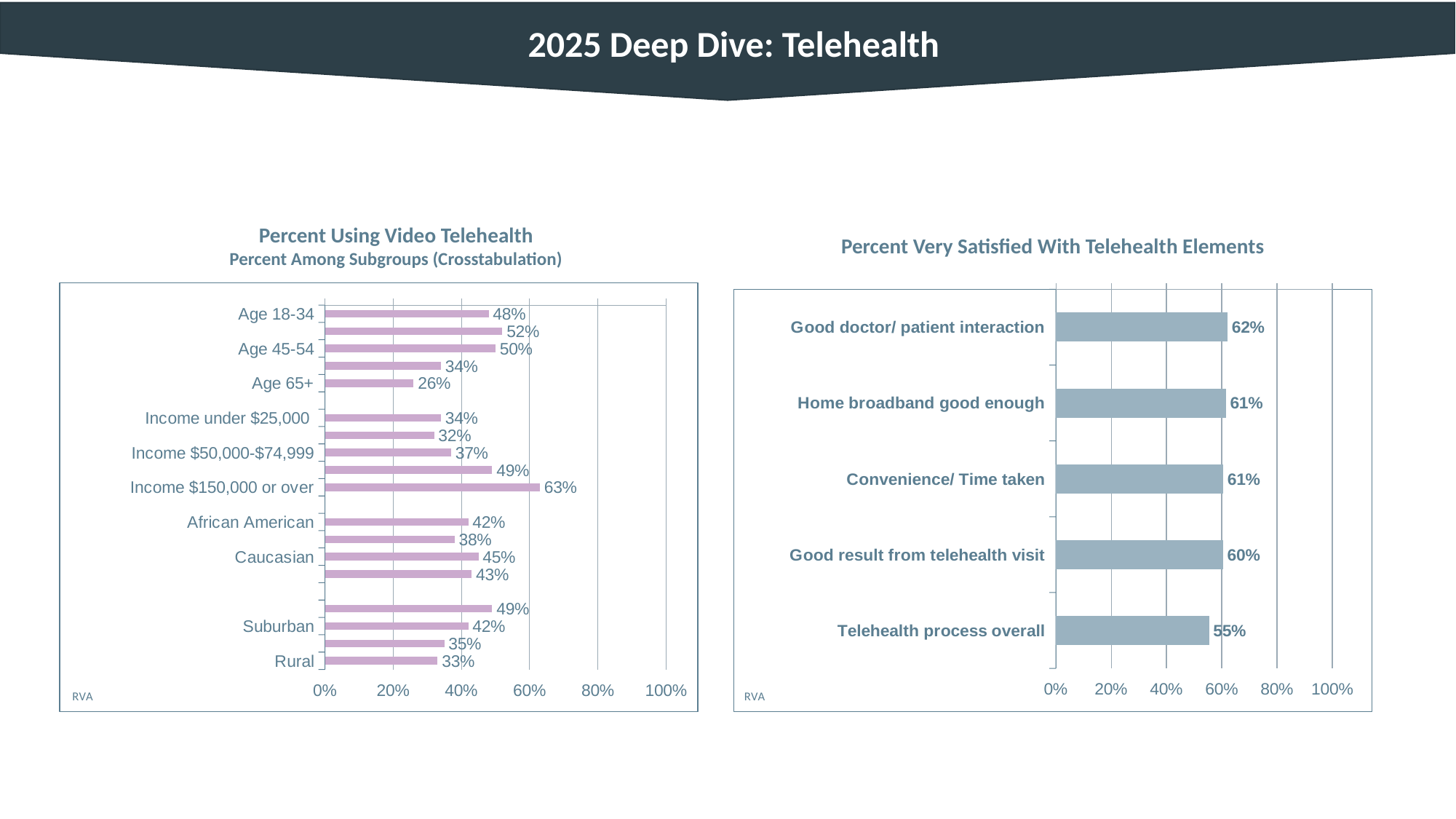
In the 'Percent Very Satisfied With Telehealth Elements' chart, how many elements are shown? 5 In the 'Percent Very Satisfied With Telehealth Elements' chart, which element has the lowest value? Telehealth process overall In the 'Percent Very Satisfied With Telehealth Elements' chart, what is the difference between Good doctor/ patient interaction and Telehealth process overall? 7% What type of chart is the 'Percent Very Satisfied With Telehealth Elements' chart? Bar chart In the 'Percent Using Video Telehealth' chart, which labeled subgroup has the highest value? Income $150,000 or over In the 'Percent Very Satisfied With Telehealth Elements' chart, what is the value for Good doctor/ patient interaction? 62% In the 'Percent Using Video Telehealth' chart, what is the difference between Caucasian and African American? 3% In the 'Percent Using Video Telehealth' chart, what is the value for Income $150,000 or over? 63% In the 'Percent Using Video Telehealth' chart, what is the value for Age 18-34? 48% In the 'Percent Very Satisfied With Telehealth Elements' chart, what is the value for Telehealth process overall? 55% In the 'Percent Using Video Telehealth' chart, which labeled subgroup has the lowest value? Age 65+ In the 'Percent Using Video Telehealth' chart, which is larger, Suburban or Rural? Suburban